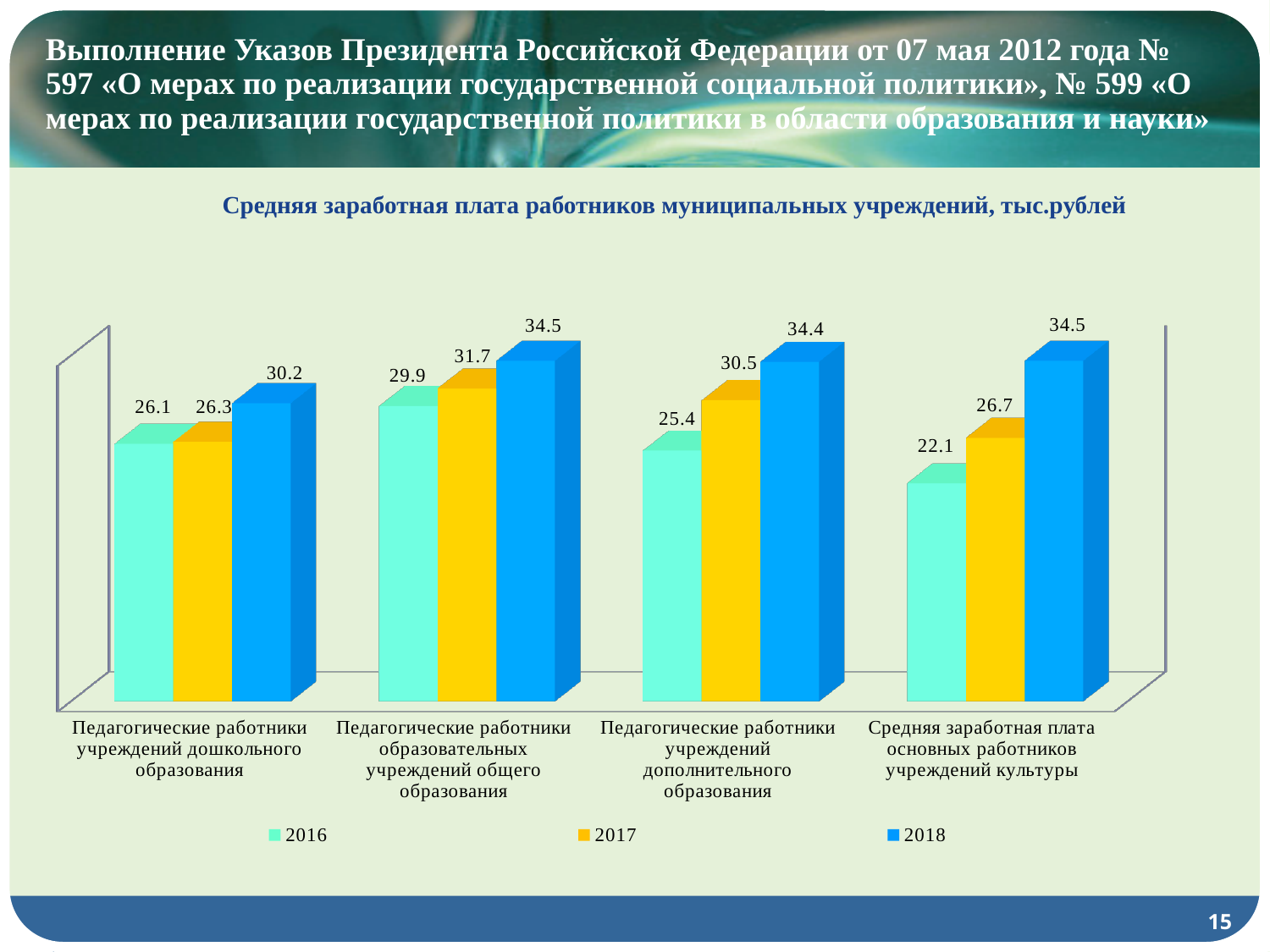
What is the difference between the 2018 and 2016 values for Средняя заработная плата основных работников учреждений культуры? 12.4 What is the 2016 value for Средняя заработная плата основных работников учреждений культуры? 22.1 What is the 2017 value for Педагогические работники учреждений дополнительного образования? 30.5 How many series does the legend list? 3 Do the values for Педагогические работники учреждений дополнительного образования rise or fall from 2016 to 2018? Rise What is the difference between the 2017 and 2016 values for Педагогические работники образовательных учреждений общего образования? 1.8 Which category has the lowest 2016 value? Средняя заработная плата основных работников учреждений культуры What kind of chart is shown on the slide? Bar chart How many categories are shown on the x axis? 4 Which category has the highest 2017 value? Педагогические работники образовательных учреждений общего образования Which is larger: the 2017 value for Педагогические работники учреждений дошкольного образования or the 2017 value for Педагогические работники учреждений дополнительного образования? Педагогические работники учреждений дополнительного образования What is the 2018 value for Педагогические работники учреждений дошкольного образования? 30.2